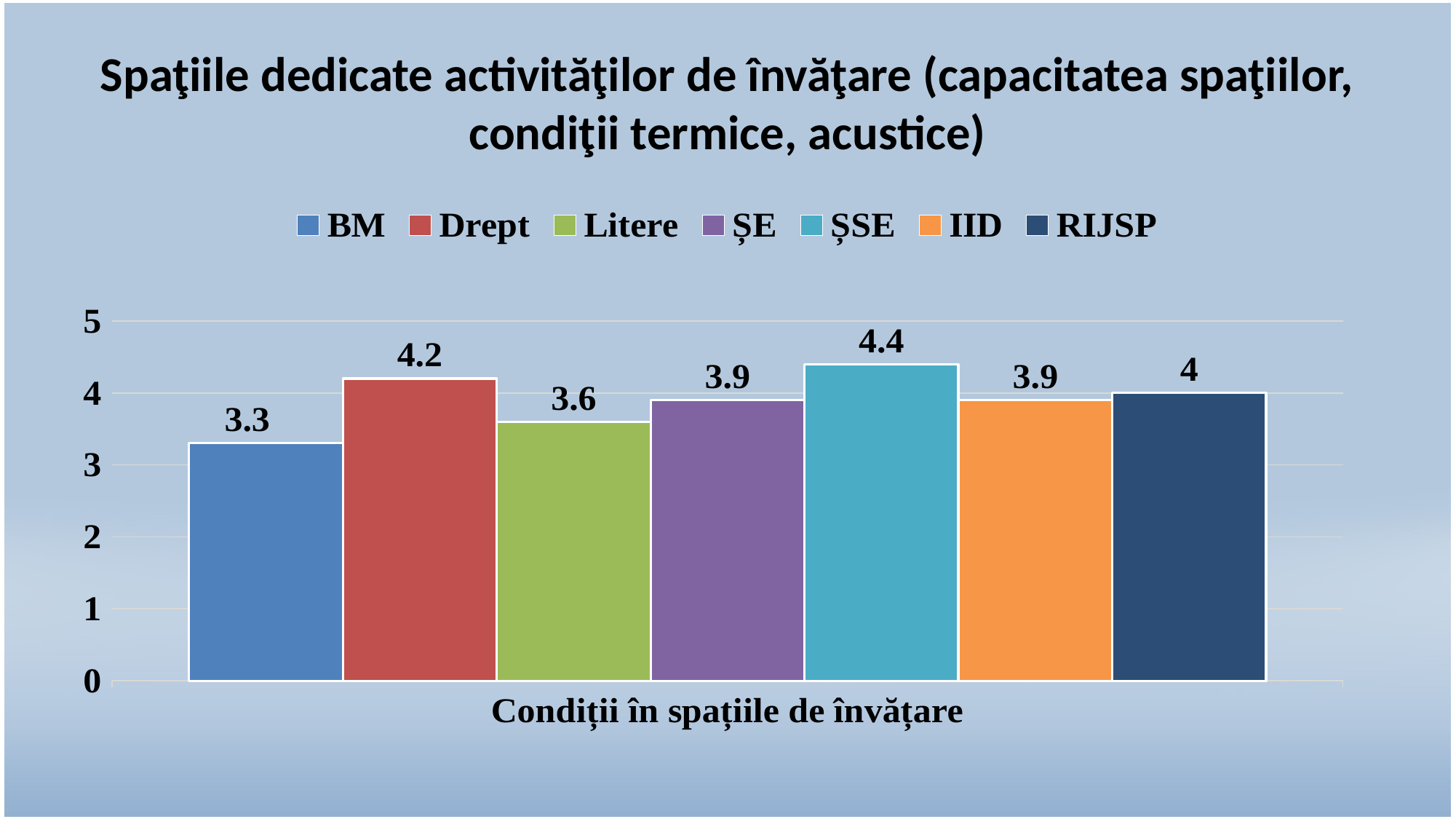
Which is larger, the value for Drept or the value for RIJSP? Drept What is the value for Litere? 3.6 What kind of chart is shown on the slide? bar chart What is the label on the x axis of the chart? Condiții în spațiile de învățare Is the value for Litere greater or less than 4? less What is the value for BM? 3.3 Which series has the highest value? ȘSE What is the difference between the values for ȘSE and BM? 1.1 What is the value for RIJSP? 4 Which series has the lowest value? BM What is the value for Drept? 4.2 How many series does the legend list? 7